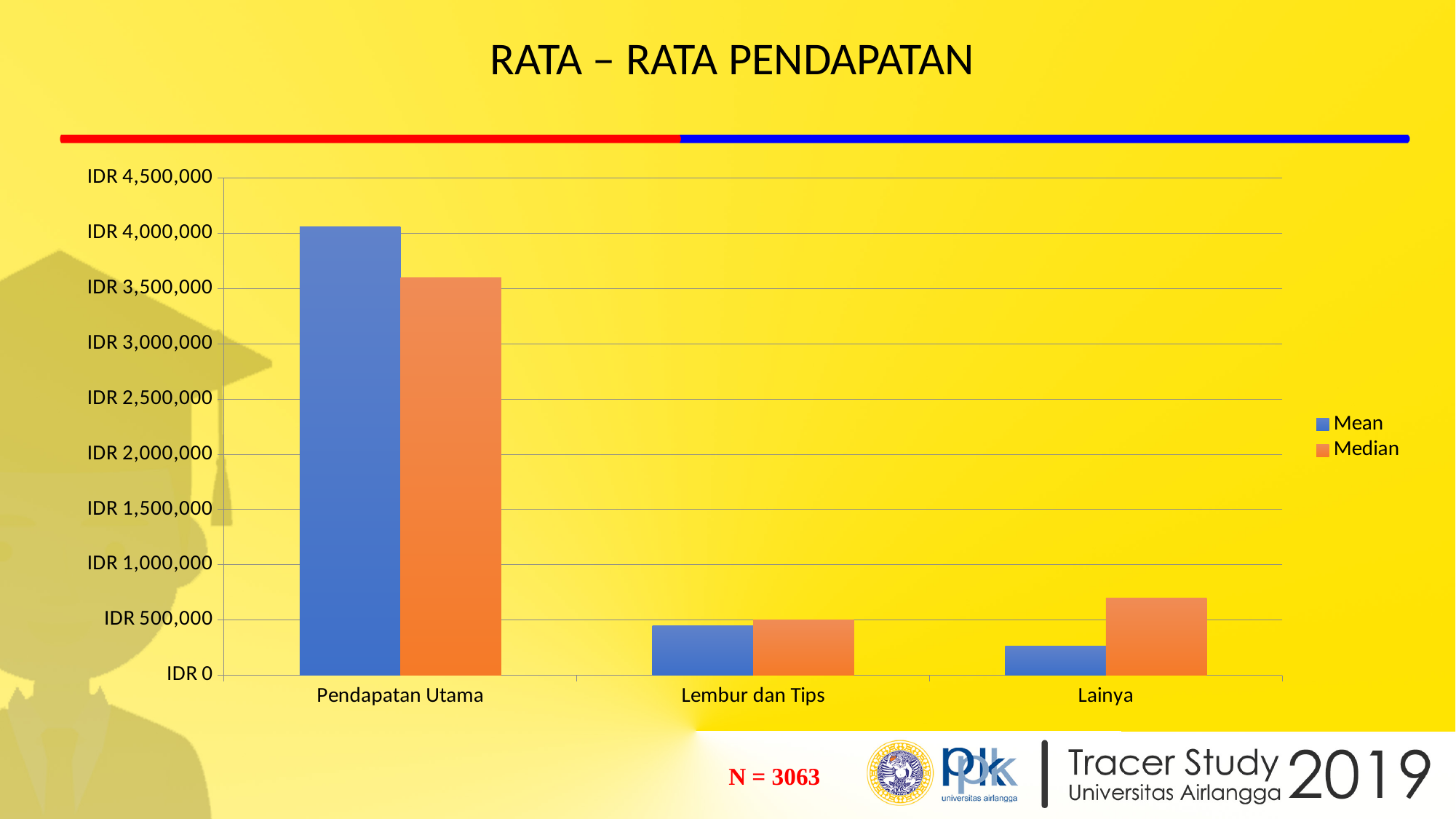
For Pendapatan Utama, which is larger, the Mean or the Median? Mean Is the Median value for Pendapatan Utama greater or less than IDR 4,000,000? less What is the title of the slide? RATA – RATA PENDAPATAN How many series does the legend list? 2 For Lainya, which is larger, the Mean or the Median? Median Is the Mean value for Pendapatan Utama greater or less than IDR 4,000,000? greater How many categories are shown on the x axis? 3 Which category has the lowest Mean value? Lainya Is the Median value for Lainya greater or less than IDR 500,000? greater What kind of chart is shown on the slide? bar chart Which category has the highest Mean value? Pendapatan Utama Which category has the lowest Median value? Lembur dan Tips